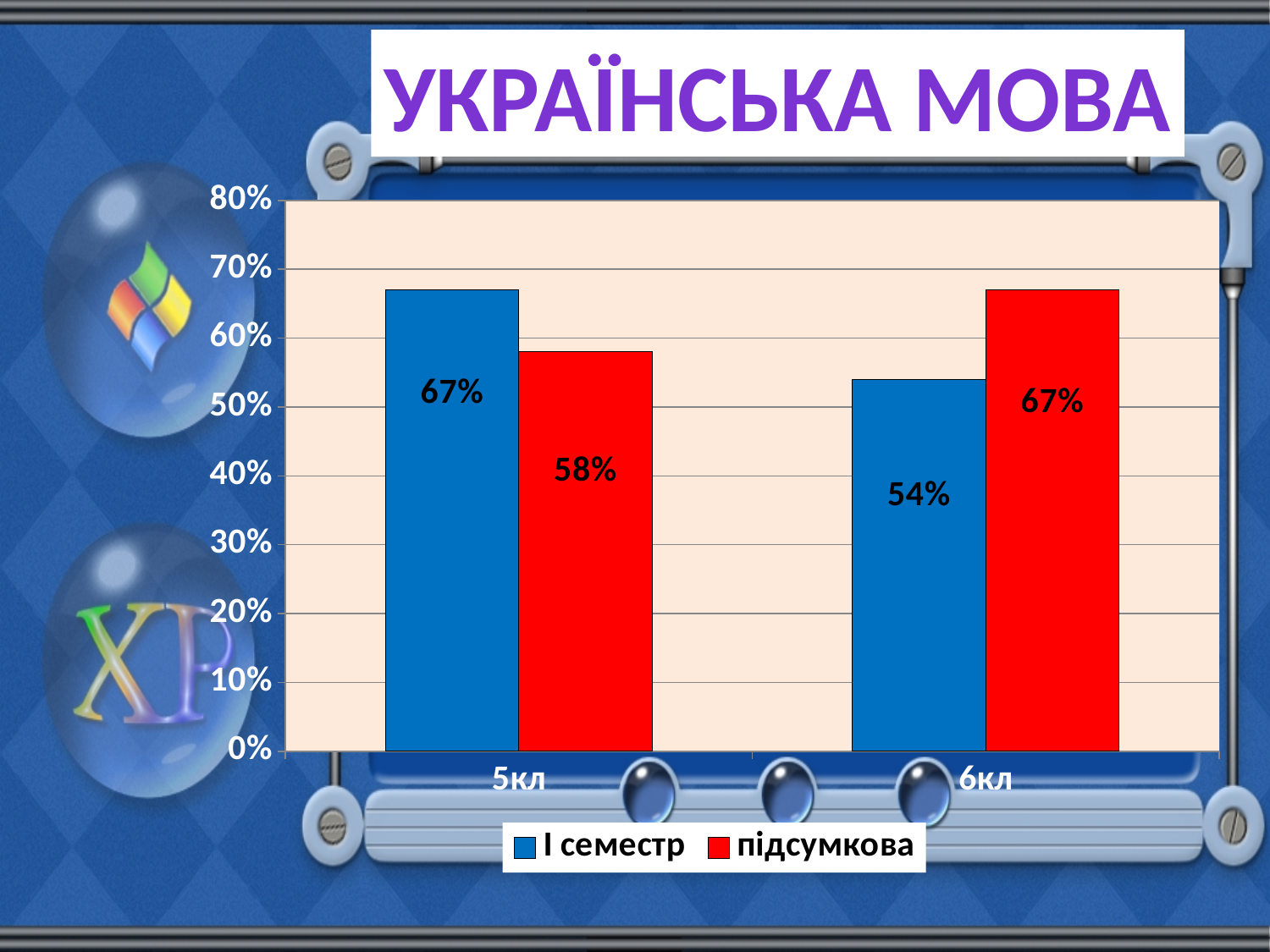
What kind of chart is shown on the slide? bar chart For 6кл, which is larger: I семестр or підсумкова? підсумкова What is the value for I семестр for 6кл? 54% What is the value for підсумкова for 5кл? 58% What is the value for підсумкова for 6кл? 67% Which category has the lowest I семестр value? 6кл How many categories are shown on the x axis? 2 How many series does the legend list? 2 What is the difference between the підсумкова and I семестр values for 6кл? 13% What is the value for I семестр for 5кл? 67% Which category has the highest підсумкова value? 6кл What is the difference between the I семестр and підсумкова values for 5кл? 9%